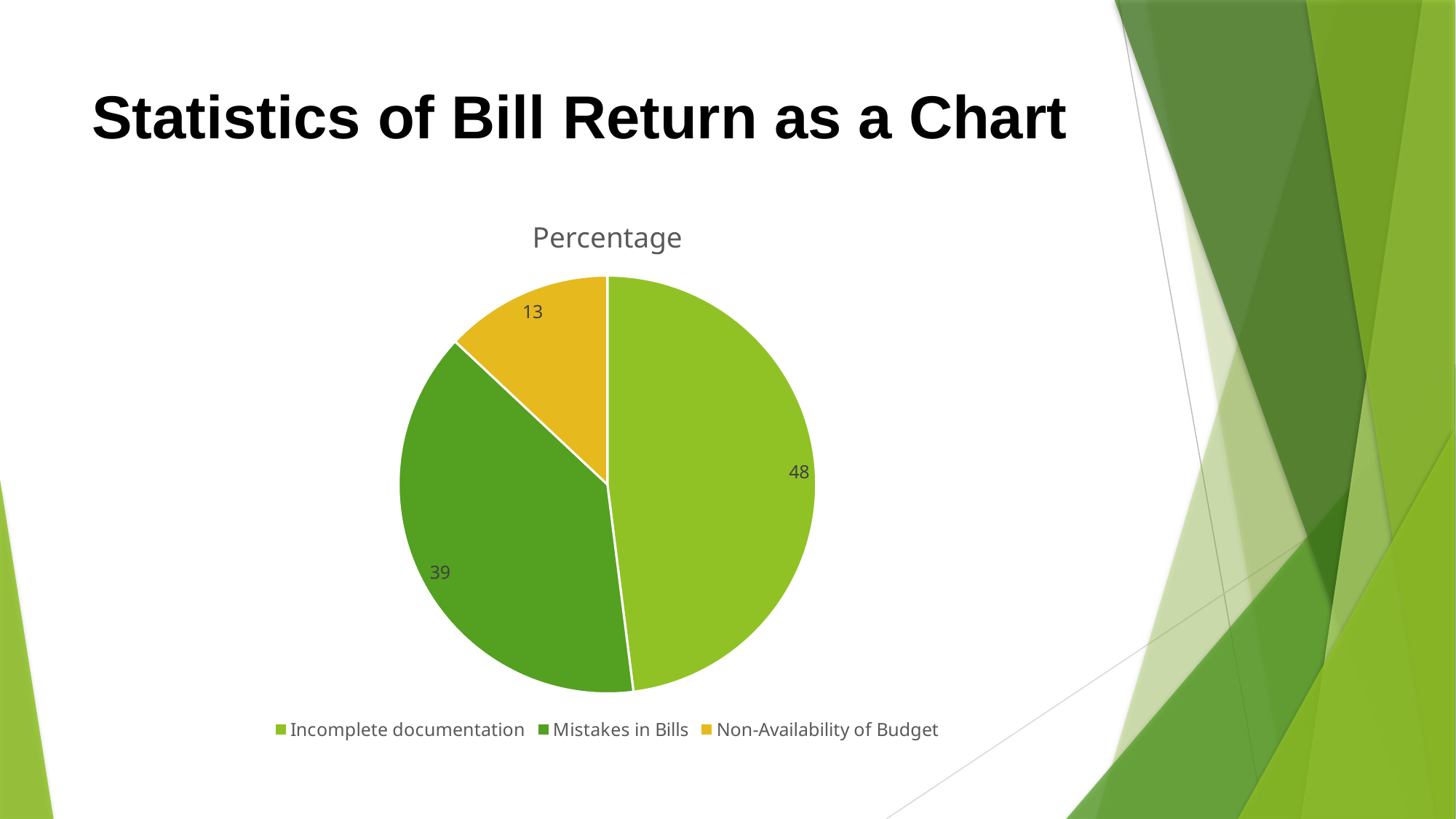
What is the difference between the values for Mistakes in Bills and Non-Availability of Budget? 26 What is the difference between the values for Incomplete documentation and Mistakes in Bills? 9 Which category has the largest slice? Incomplete documentation What type of chart is shown on the slide? pie chart What colour is the slice for Non-Availability of Budget? yellow Which category has the smallest slice? Non-Availability of Budget Which is larger, the value for Mistakes in Bills or the value for Non-Availability of Budget? Mistakes in Bills How many slices does the pie chart have? 3 What is the value for Mistakes in Bills? 39 What is the value for Non-Availability of Budget? 13 What is the value for Incomplete documentation? 48 What is the chart's title? Percentage